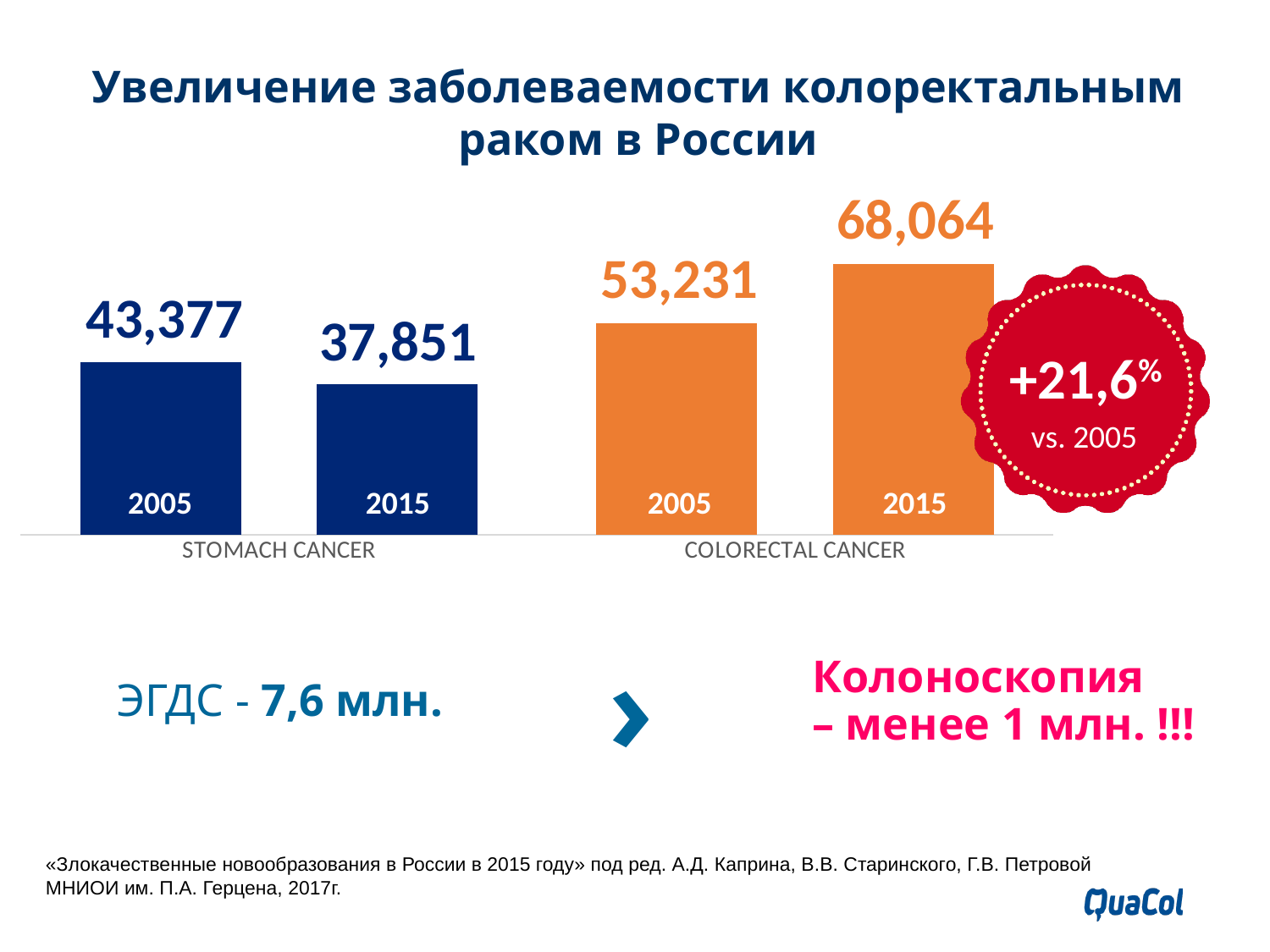
Which bar has the highest value? Colorectal cancer 2015 What is the value for colorectal cancer in 2005? 53,231 What is the difference between the colorectal cancer values for 2015 and 2005? 14,833 Did the colorectal cancer value rise or fall from 2005 to 2015? Rise What is the value for stomach cancer in 2005? 43,377 How many bars are plotted in the chart? 4 Which bar has the lowest value? Stomach cancer 2015 What is the value for stomach cancer in 2015? 37,851 What kind of chart is shown on the slide? Bar chart Which is larger: stomach cancer in 2005 or colorectal cancer in 2005? Colorectal cancer in 2005 What is the difference between the stomach cancer values for 2005 and 2015? 5,526 What is the value for colorectal cancer in 2015? 68,064